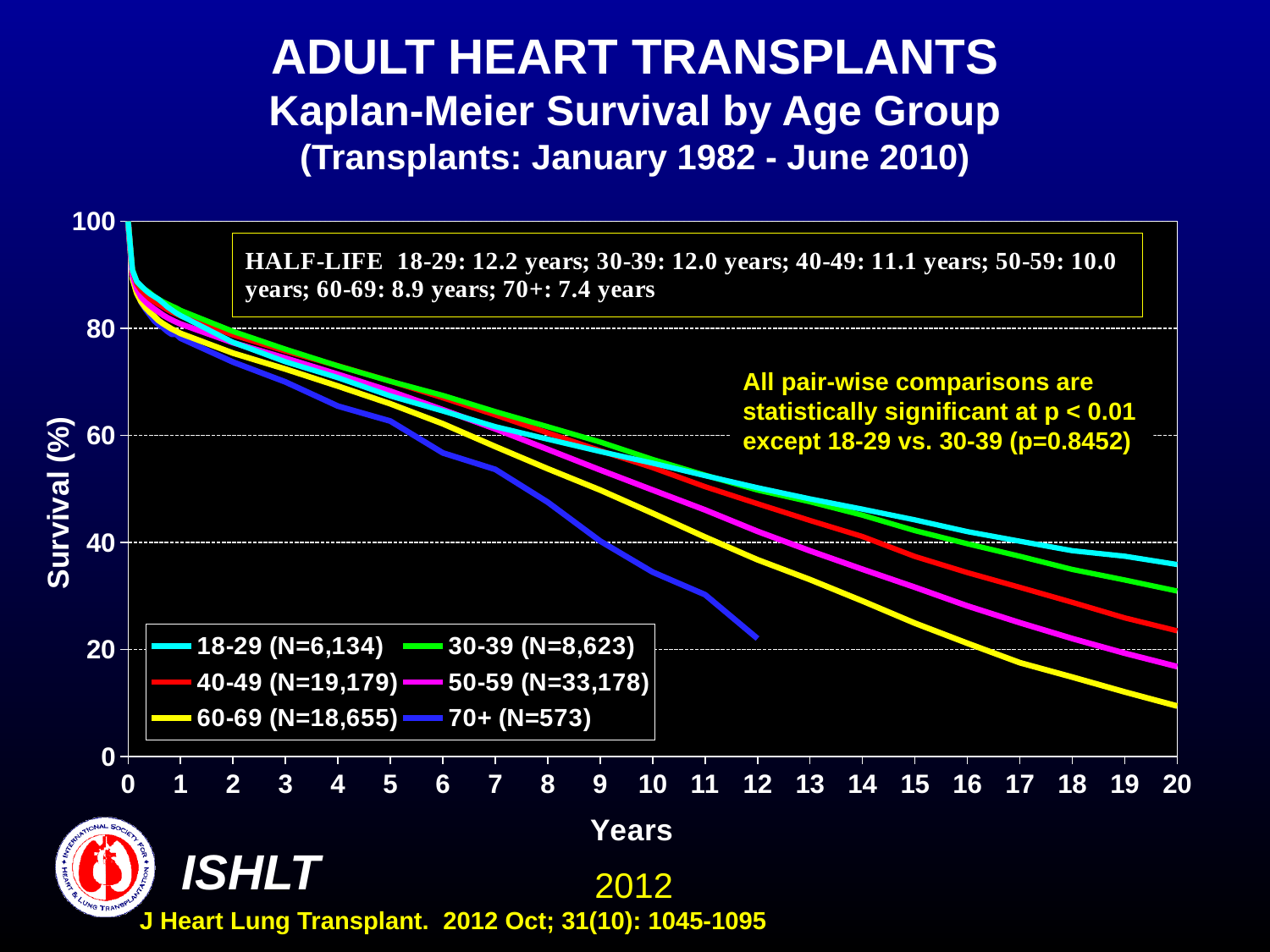
What is the half-life for the 18-29 age group? 12.2 years Which age group has the smallest N in the legend? 70+ (N=573) What kind of chart is shown on the slide? line chart How many age groups (series) does the legend list? 6 Is the survival for the 70+ group at 10 years greater or less than 40? less Which age group has the lowest survival at 20 years? 60-69 What is the N for the 50-59 age group shown in the legend? 33,178 Which has the longer half-life, the 40-49 group or the 50-59 group? 40-49 What is the half-life for the 60-69 age group? 8.9 years What is the difference between the half-life of the 18-29 group and the 70+ group? 4.8 years What p-value is given for the 18-29 vs. 30-39 comparison? p=0.8452 Which age group has the shortest half-life? 70+